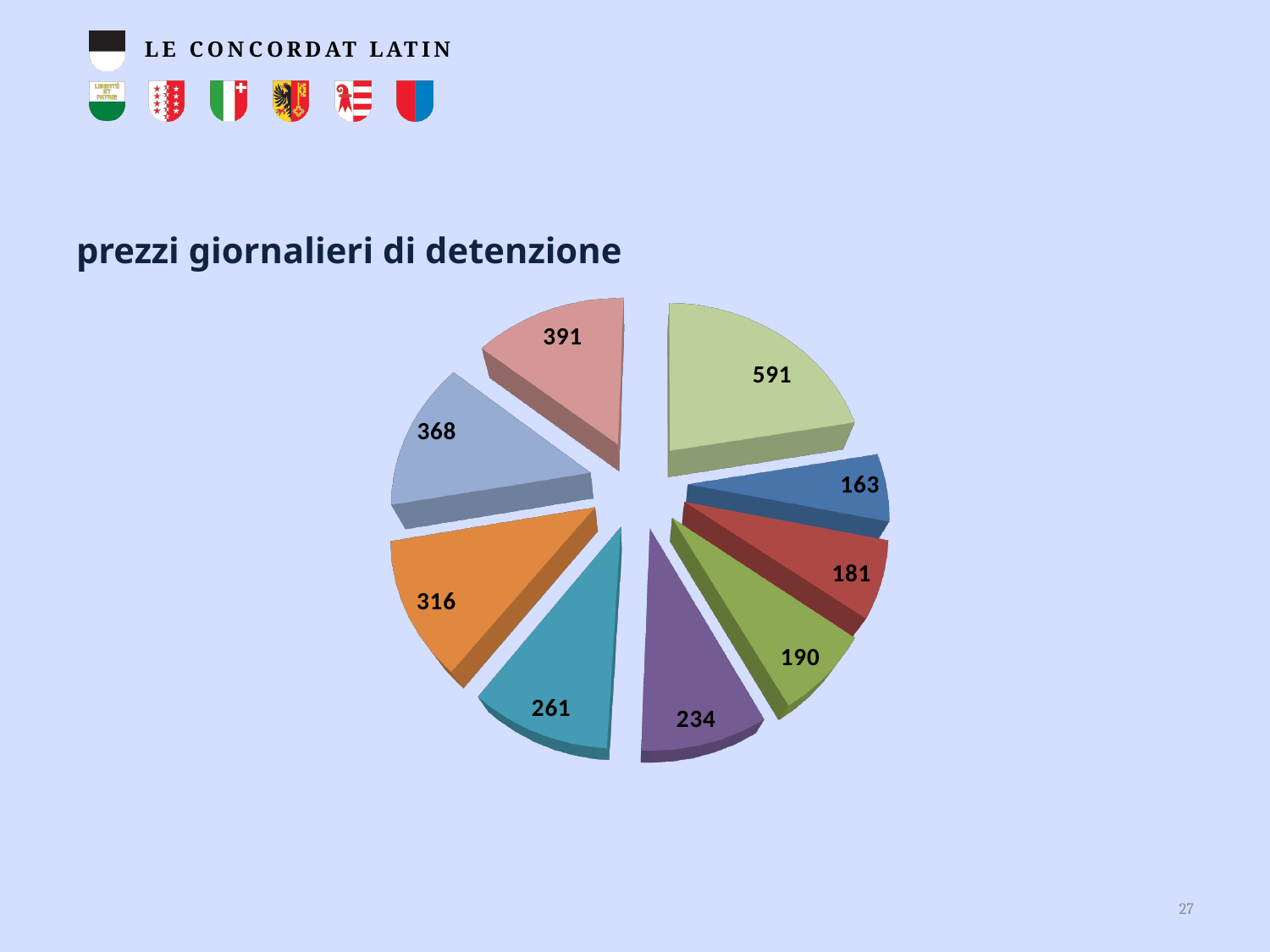
What is the total of all the slice values shown in the pie chart? 2695 How many slices does the pie chart have? 9 What is the difference between the largest slice value (591) and the smallest slice value (163)? 428 What value is shown on the salmon-coloured slice at the top left of the pie chart? 391 Which slice has the larger value, the teal slice (261) or the purple slice (234)? the teal slice (261) What is the title of the chart on the slide? prezzi giornalieri di detenzione What value is shown on the orange slice of the pie chart? 316 What value is shown on the light green slice at the top right of the pie chart? 591 What is the largest value shown in the pie chart? 591 What value is shown on the purple slice of the pie chart? 234 What is the smallest value shown in the pie chart? 163 What kind of chart is shown on the slide? pie chart